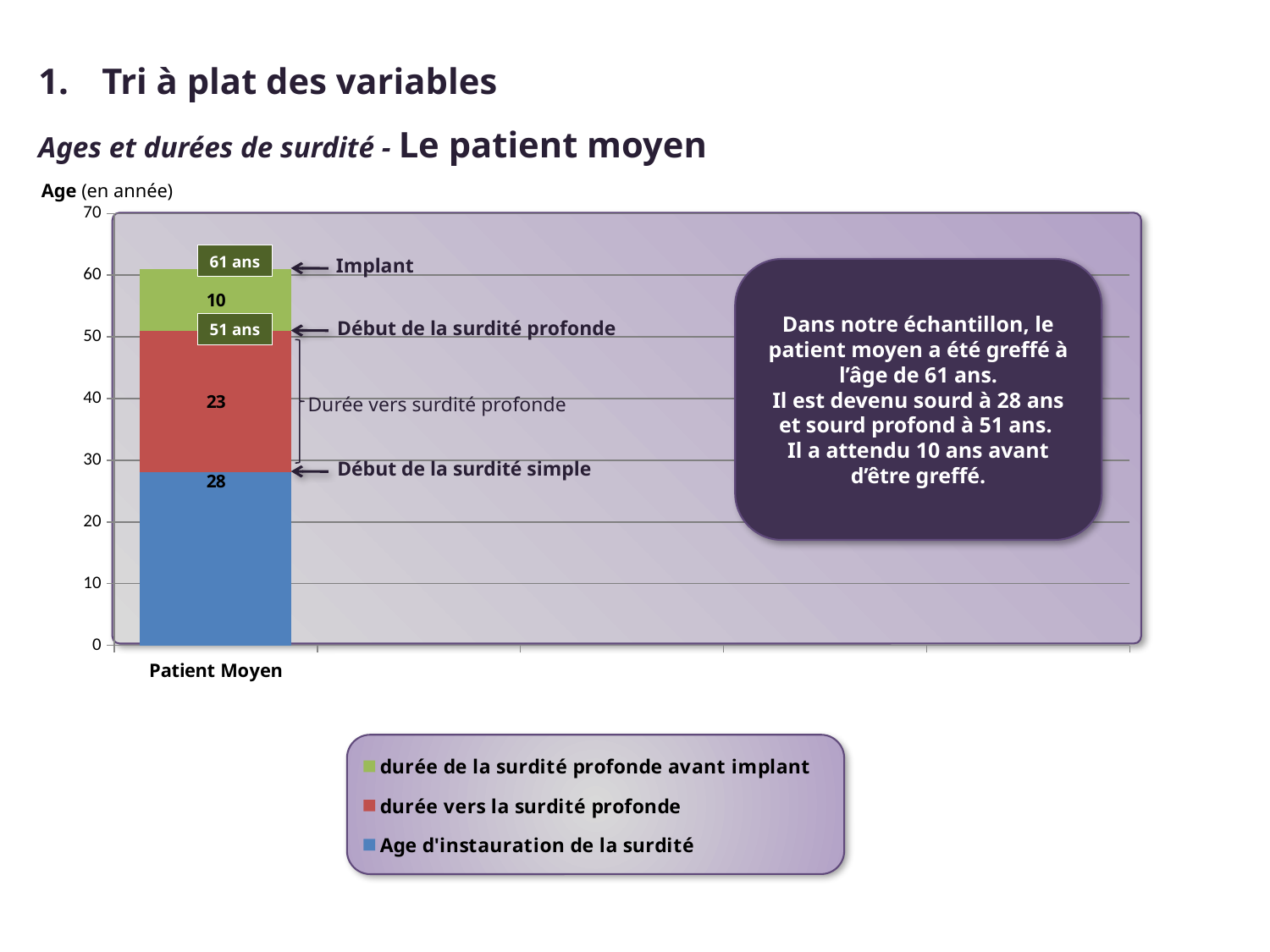
What is the difference between the "Age d'instauration de la surdité" segment and the "durée vers la surdité profonde" segment? 5 What colour is the "Age d'instauration de la surdité" series in the legend? blue What kind of chart is shown on the slide? stacked bar chart What is the value of the "durée vers la surdité profonde" segment for Patient Moyen? 23 Which segment of the Patient Moyen bar has the smallest value? durée de la surdité profonde avant implant Which is larger: the "durée vers la surdité profonde" segment or the "durée de la surdité profonde avant implant" segment? durée vers la surdité profonde Which segment of the Patient Moyen bar has the largest value? Age d'instauration de la surdité How many categories are plotted on the x axis? 1 What is the total height of the stacked bar for Patient Moyen? 61 How many series does the legend list? 3 What is the value of the "durée de la surdité profonde avant implant" segment for Patient Moyen? 10 What is the value of the "Age d'instauration de la surdité" segment for Patient Moyen? 28